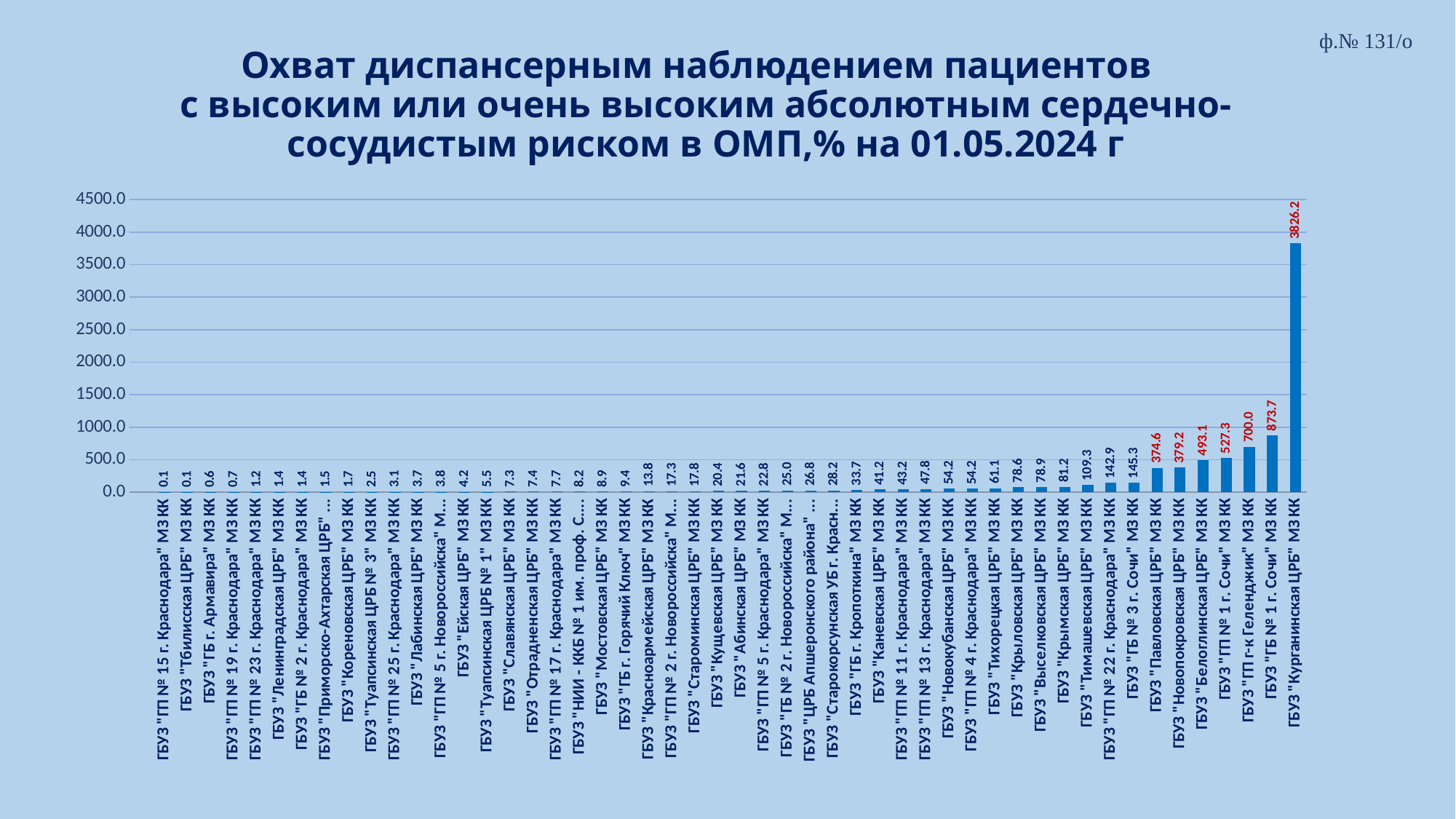
What is the lowest value shown on the chart? 0.1 What is the value for ГБУЗ "Белоглинская ЦРБ" МЗ КК? 493.1 What kind of chart is shown on the slide? bar chart What is the difference between the values for ГБУЗ "ГБ № 1 г. Сочи" МЗ КК and ГБУЗ "ГП г-к Геленджик" МЗ КК? 173.7 Is the value for ГБУЗ "Курганинская ЦРБ" МЗ КК greater or less than 3500.0? greater What is the value for ГБУЗ "Курганинская ЦРБ" МЗ КК? 3826.2 Do the values rise or fall from left to right along the x axis? rise How many categories are plotted on the chart? 50 What is the value for ГБУЗ "Тимашевская ЦРБ" МЗ КК? 109.3 Which category has the highest value? ГБУЗ "Курганинская ЦРБ" МЗ КК Which is larger: the value for ГБУЗ "Павловская ЦРБ" МЗ КК or ГБУЗ "Новопокровская ЦРБ" МЗ КК? ГБУЗ "Новопокровская ЦРБ" МЗ КК What is the value for ГБУЗ "ГП г-к Геленджик" МЗ КК? 700.0